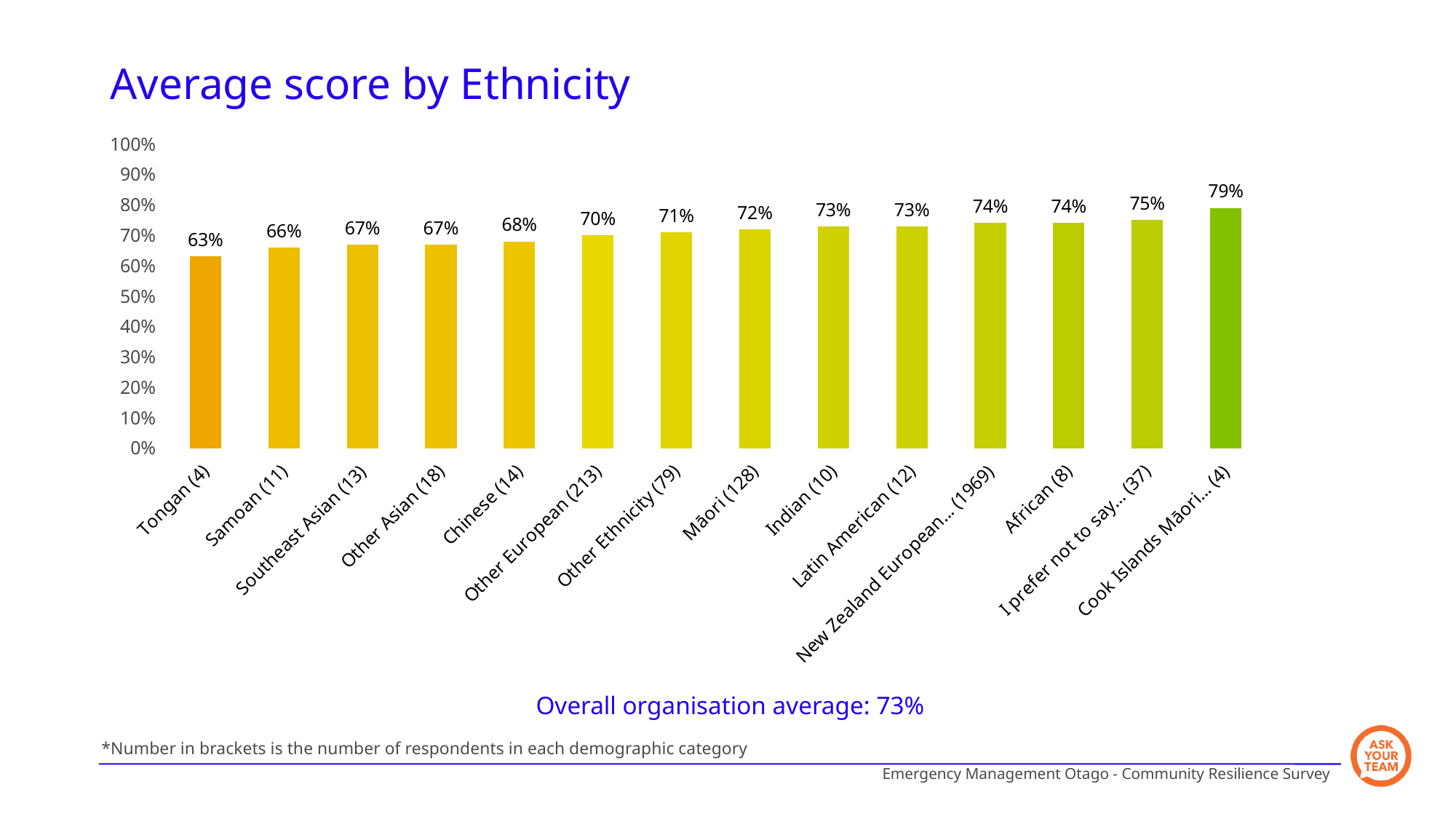
What type of chart is shown on the slide? bar chart What is the average score for Māori (128)? 72% Which ethnicity has the lowest average score? Tongan (4) What is the difference between the average score for Cook Islands Māori... (4) and Tongan (4)? 16% Do the average scores rise or fall from left to right across the categories? rise How many ethnicity categories are shown in the chart? 14 What is the average score for Other European (213)? 70% Is the average score for Samoan (11) greater or less than 70%? less What is the overall organisation average stated on the slide? 73% Which has a higher average score, Chinese (14) or Indian (10)? Indian (10) Which ethnicity has the highest average score? Cook Islands Māori... (4) What is the average score for Tongan (4)? 63%